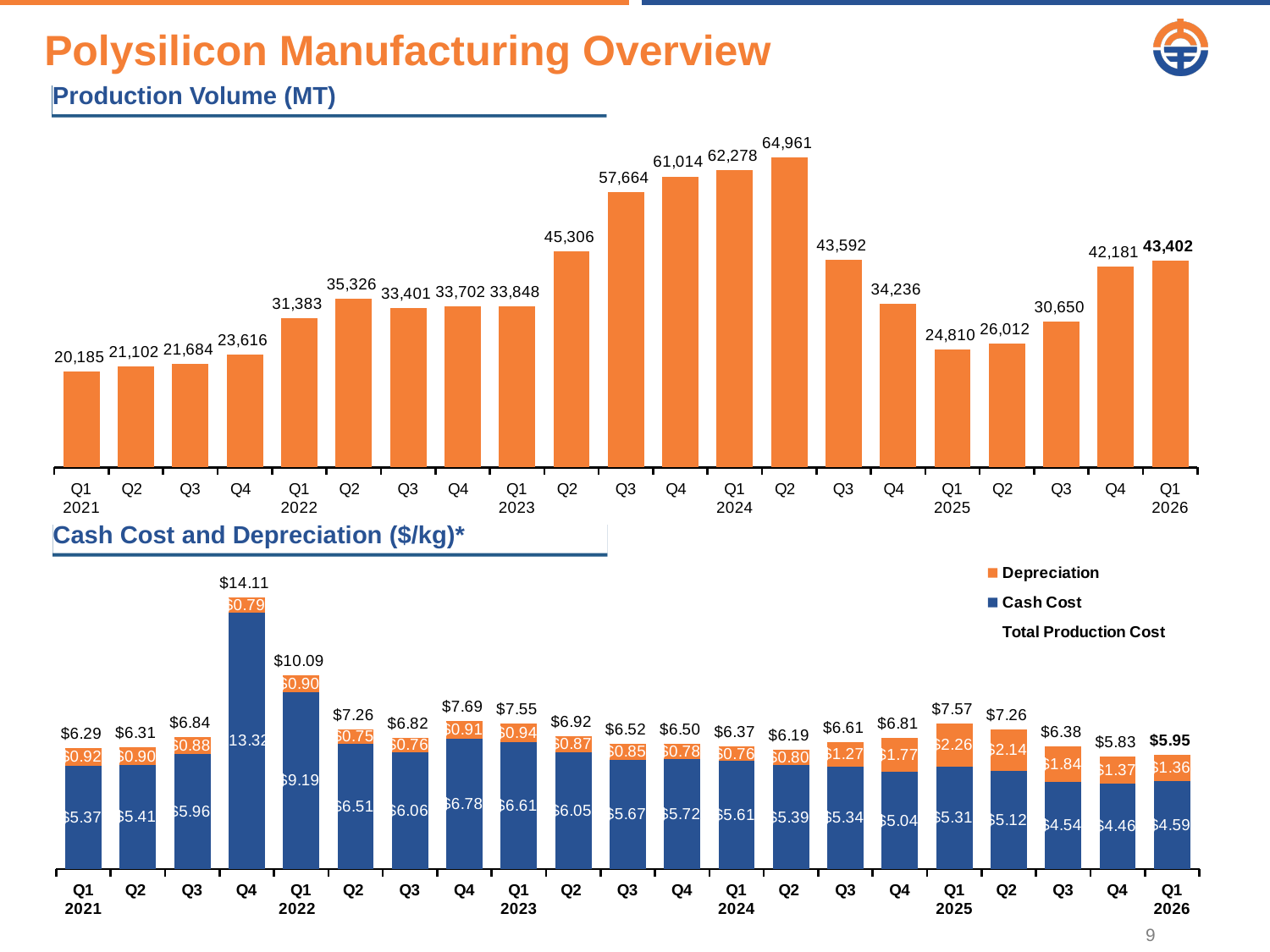
In the Production Volume (MT) chart, do the values rise or fall from Q1 2021 to Q2 2024? Rise In the Production Volume (MT) chart, which quarter has the lowest production volume? Q1 2021 In the Cash Cost and Depreciation ($/kg) chart, what is the depreciation for Q1 2025? $2.26 In the Production Volume (MT) chart, what is the production volume for Q2 2024? 64,961 What kind of chart is the Production Volume (MT) chart? Bar chart How many quarters are plotted in the Production Volume (MT) chart? 21 How many entries does the legend of the Cash Cost and Depreciation ($/kg) chart list? 3 In the Cash Cost and Depreciation ($/kg) chart, which is larger, the total production cost for Q1 2026 or for Q4 2025? Q1 2026 In the Production Volume (MT) chart, which quarter has the highest production volume? Q2 2024 In the Cash Cost and Depreciation ($/kg) chart, what is the total production cost for Q4 2021? $14.11 In the Cash Cost and Depreciation ($/kg) chart, which quarter has the highest total production cost? Q4 2021 In the Production Volume (MT) chart, what is the difference between the production volume in Q1 2026 and Q1 2025? 18,592